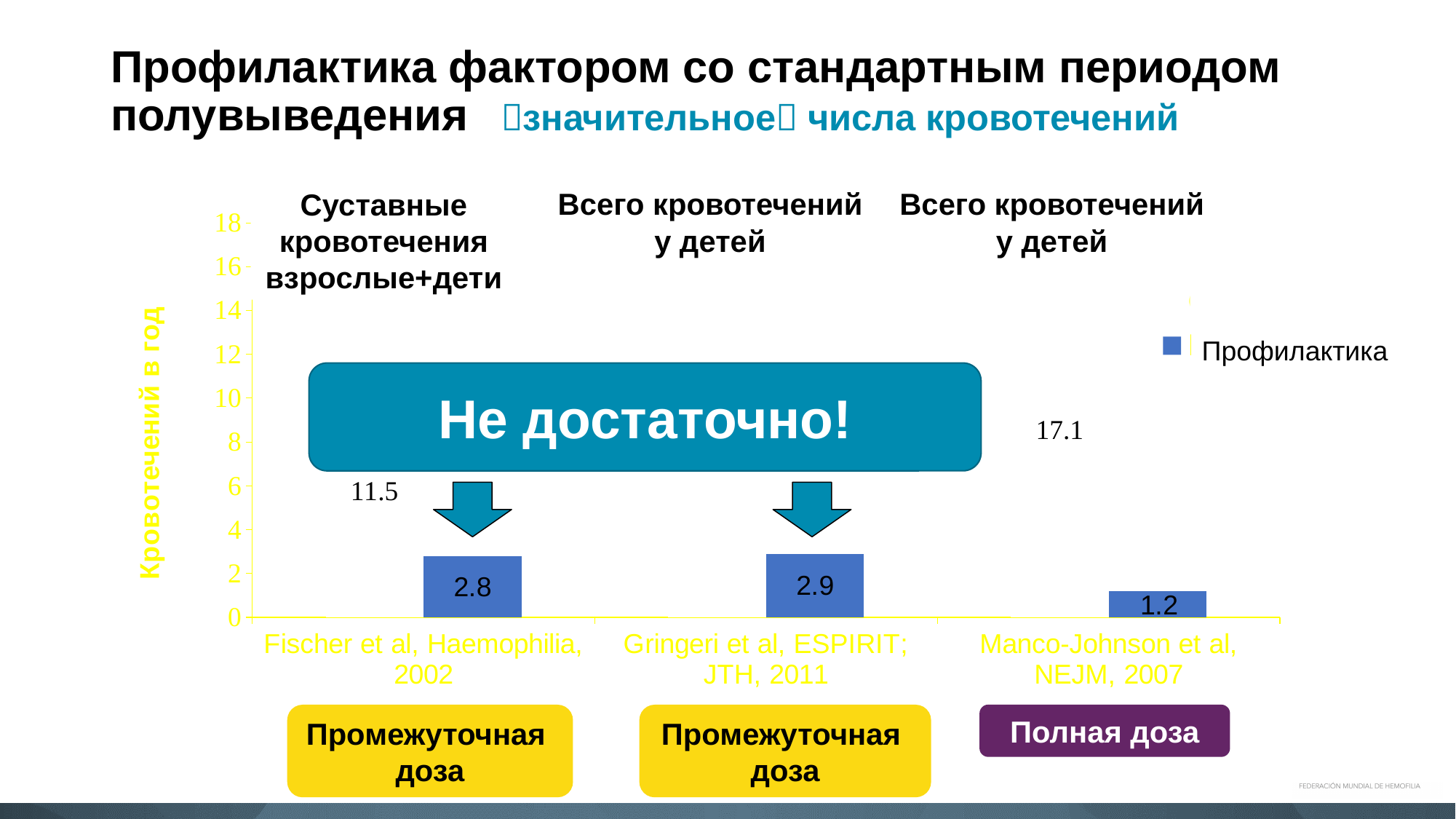
What is the value for Fischer et al, Haemophilia, 2002? 2.8 Is the value for Fischer et al, Haemophilia, 2002 greater or less than 4? less What is the value for Gringeri et al, ESPIRIT; JTH, 2011? 2.9 Which is larger, the value for Gringeri et al, ESPIRIT; JTH, 2011 or the value for Manco-Johnson et al, NEJM, 2007? Gringeri et al, ESPIRIT; JTH, 2011 What is the difference between the values for Gringeri et al, ESPIRIT; JTH, 2011 and Fischer et al, Haemophilia, 2002? 0.1 What is the title of the vertical axis of the chart? Кровотечений в год What is the value for Manco-Johnson et al, NEJM, 2007? 1.2 What kind of chart is shown on the slide? bar chart Which category has the highest bar? Gringeri et al, ESPIRIT; JTH, 2011 What is the difference between the values for Fischer et al, Haemophilia, 2002 and Manco-Johnson et al, NEJM, 2007? 1.6 Which category has the lowest bar? Manco-Johnson et al, NEJM, 2007 How many categories are shown on the x axis of the chart? 3